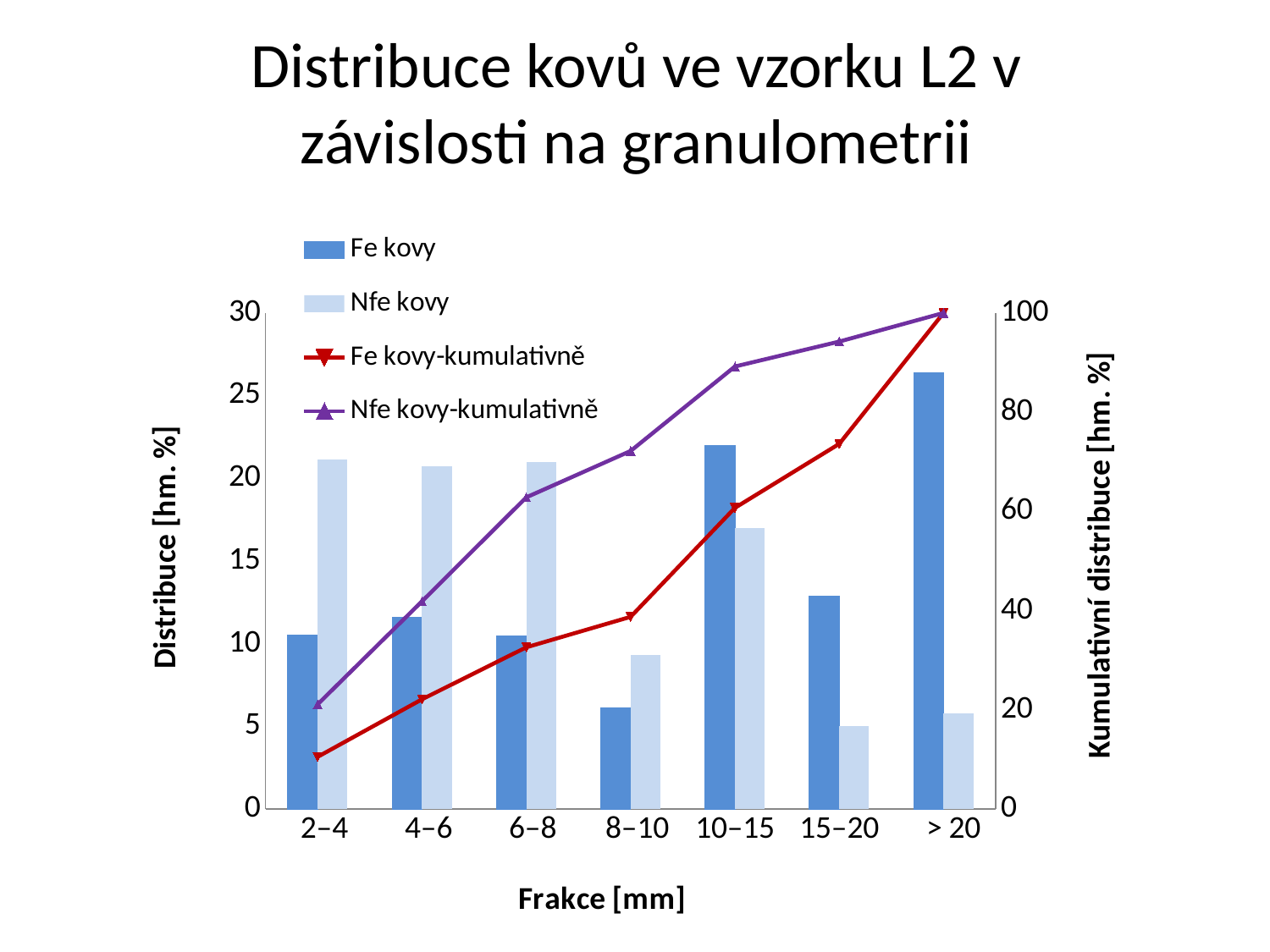
For the 10–15 fraction, which is larger: Fe kovy or Nfe kovy? Fe kovy What is the title of the right-hand vertical axis? Kumulativní distribuce [hm. %] For the 2–4 fraction, which is larger: Fe kovy or Nfe kovy? Nfe kovy What kind of chart is shown on the slide? A combined bar and line chart Do the Fe kovy-kumulativně and Nfe kovy-kumulativně lines rise or fall from the 2–4 fraction to the > 20 fraction? rise Which fraction has the lowest Fe kovy bar? 8–10 How many series does the legend list? 4 Is the Fe kovy value for the > 20 fraction greater or less than 25? greater How many fraction categories are shown on the x axis? 7 Is the Nfe kovy value for the 8–10 fraction greater or less than 10? less Which fraction has the highest Fe kovy bar? > 20 Is the Fe kovy value for the 10–15 fraction greater or less than 20? greater